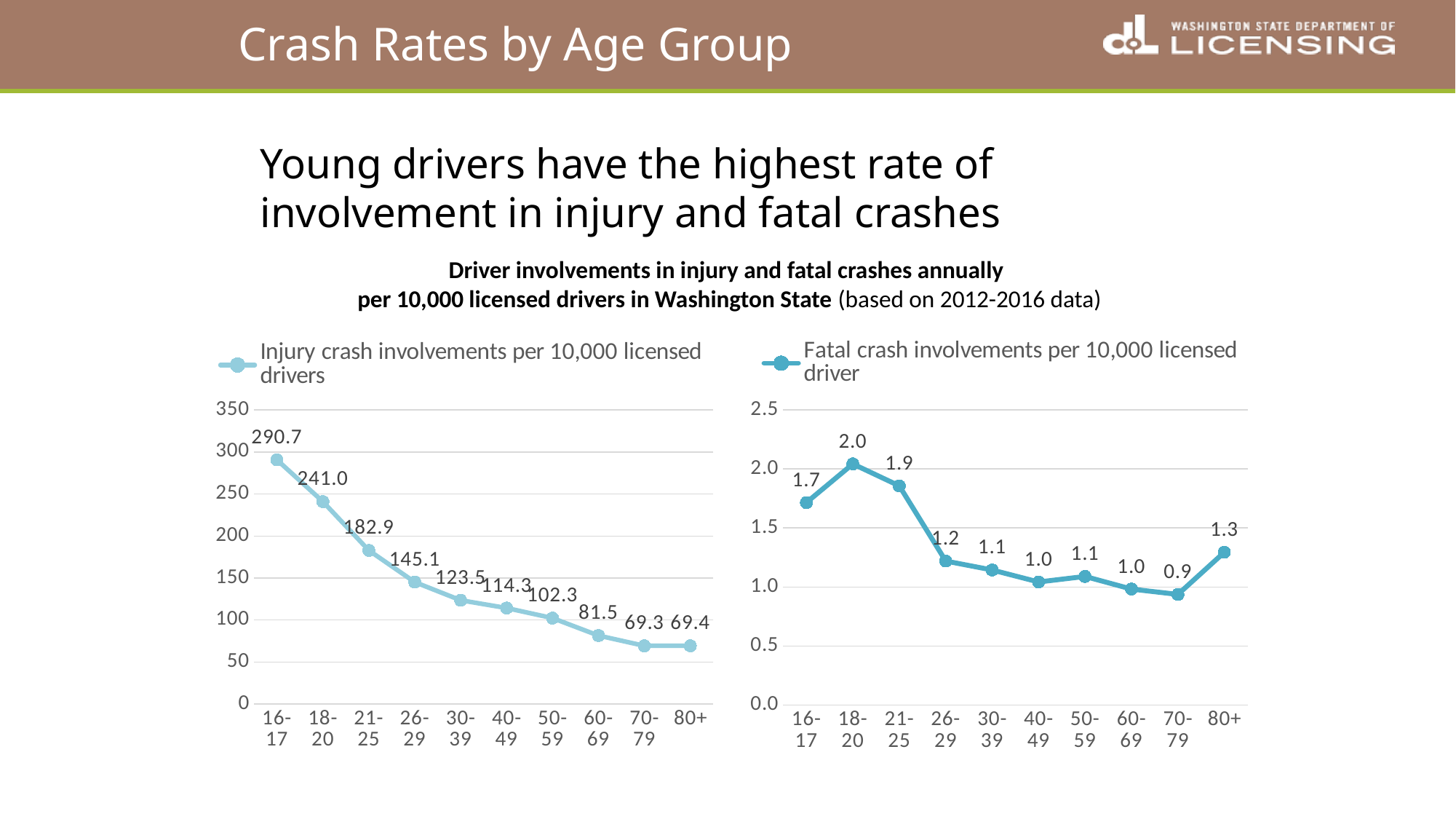
In the left chart (injury crash involvements), which age group has the highest value? 16-17 In the right chart (fatal crash involvements), which age group has the highest value? 18-20 In the left chart (injury crash involvements), what is the value for the 16-17 age group? 290.7 In the left chart (injury crash involvements), which is larger: the value for 26-29 or the value for 40-49? 26-29 What kind of chart is the right chart (fatal crash involvements)? Line chart In the left chart (injury crash involvements), what is the value for the 60-69 age group? 81.5 In the left chart (injury crash involvements), what is the difference between the values for 16-17 and 18-20? 49.7 How many age groups are shown on the x axis of the left chart (injury crash involvements)? 10 In the right chart (fatal crash involvements), which age group has the lowest value? 70-79 In the right chart (fatal crash involvements), what is the difference between the values for 21-25 and 26-29? 0.7 In the left chart (injury crash involvements), do the values generally rise or fall from the 16-17 group to the 70-79 group? Fall In the right chart (fatal crash involvements), what is the value for the 18-20 age group? 2.0